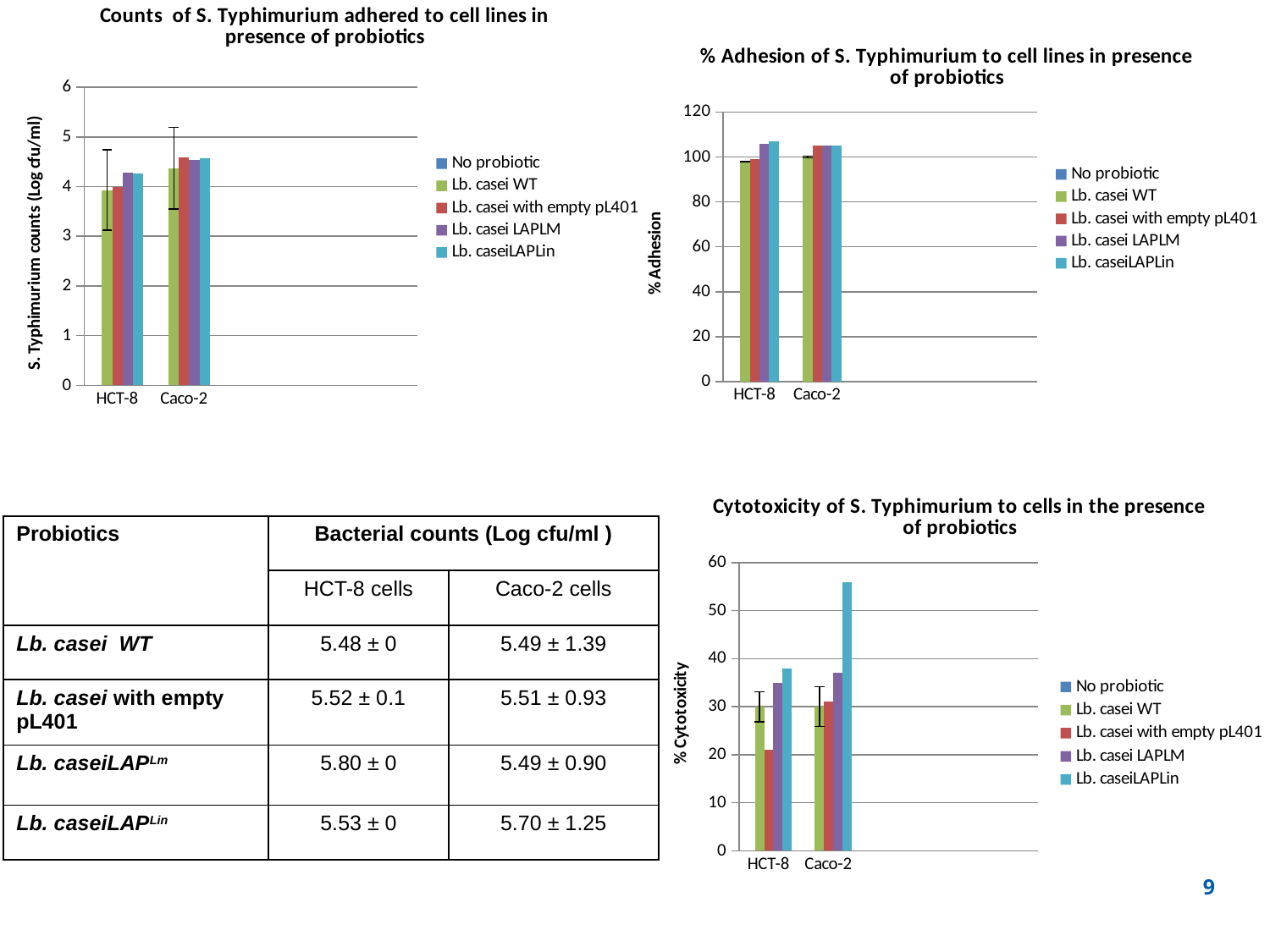
In the 'Counts of S. Typhimurium adhered to cell lines in presence of probiotics' chart, is the value for Lb. casei with empty pL401 at Caco-2 greater or less than 4? greater How many series does the legend list in the 'Counts of S. Typhimurium adhered to cell lines in presence of probiotics' chart? 5 How many cell line categories are shown on the x axis of the '% Adhesion of S. Typhimurium to cell lines in presence of probiotics' chart? 2 In the '% Adhesion of S. Typhimurium to cell lines in presence of probiotics' chart, is the value for Lb. caseiLAPLin at HCT-8 greater or less than 100? greater What is the y-axis title of the '% Adhesion of S. Typhimurium to cell lines in presence of probiotics' chart? % Adhesion In the 'Cytotoxicity of S. Typhimurium to cells in the presence of probiotics' chart, which bar is the lowest? Lb. casei with empty pL401 for HCT-8 In the 'Cytotoxicity of S. Typhimurium to cells in the presence of probiotics' chart, is the value for Lb. caseiLAPLin at Caco-2 greater or less than 50? greater In the 'Cytotoxicity of S. Typhimurium to cells in the presence of probiotics' chart, which bar is the highest? Lb. caseiLAPLin for Caco-2 In the 'Cytotoxicity of S. Typhimurium to cells in the presence of probiotics' chart, which is larger: Lb. caseiLAPLin at HCT-8 or Lb. caseiLAPLin at Caco-2? Lb. caseiLAPLin at Caco-2 What is the y-axis title of the 'Counts of S. Typhimurium adhered to cell lines in presence of probiotics' chart? S. Typhimurium counts (Log cfu/ml) What kind of chart is the 'Cytotoxicity of S. Typhimurium to cells in the presence of probiotics' chart? Bar chart